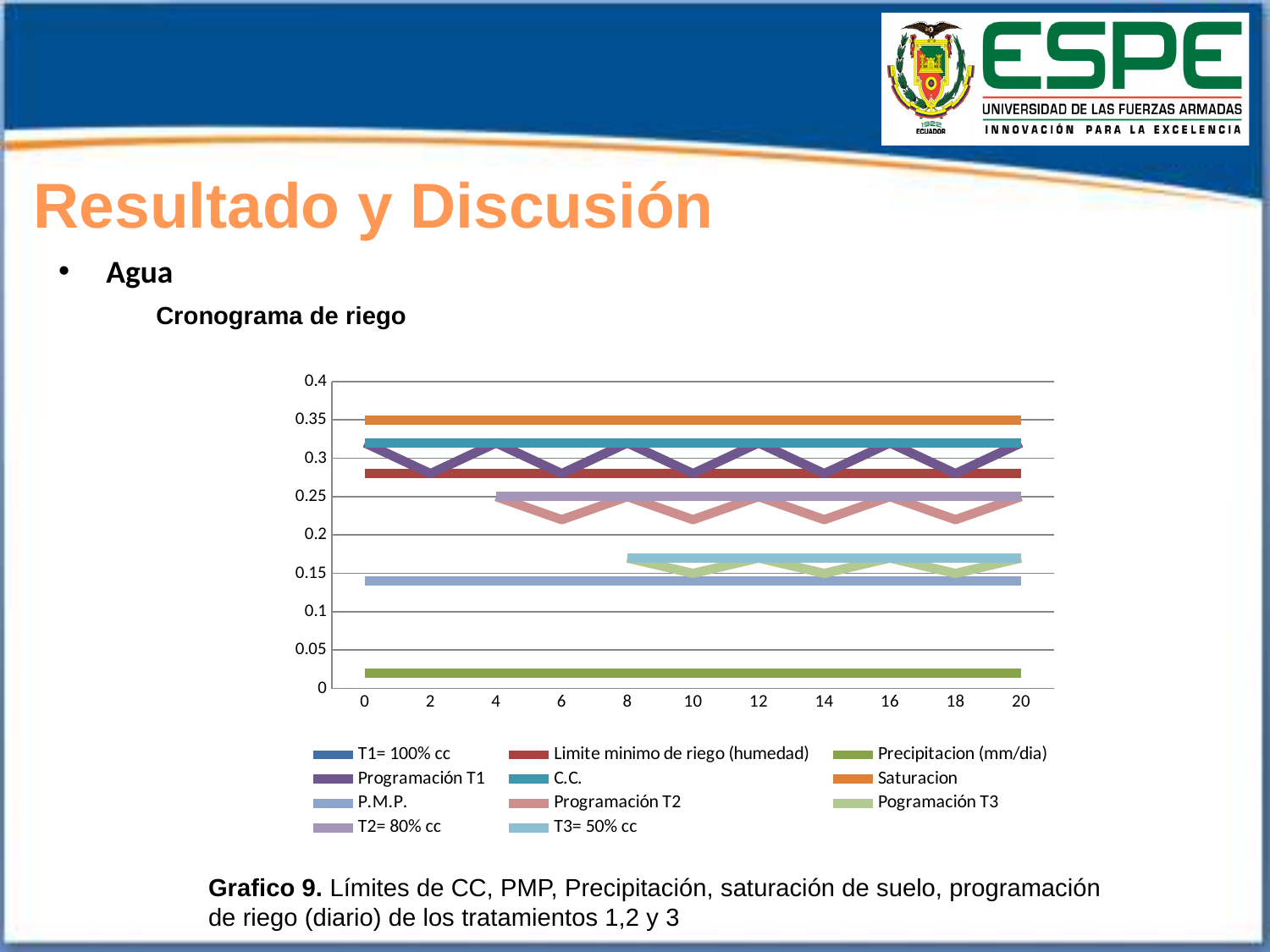
What is the title shown above the chart? Cronograma de riego Is the value of the P.M.P. line greater or less than 0.15? less Which series has the lowest values in the chart? Precipitacion (mm/dia) Which is higher, the C.C. line or the Limite minimo de riego (humedad) line? C.C. Does the Saturacion line rise, fall or stay flat along the x axis? stays flat Which series has the highest values in the chart? Saturacion What is the value of the Saturacion line? 0.35 Is the value of the Precipitacion (mm/dia) line greater or less than 0.05? less What is the value of the T2= 80% cc line? 0.25 How many series does the legend of the chart list? 11 What kind of chart is shown on the slide? line chart Is the value of the C.C. line greater or less than 0.3? greater